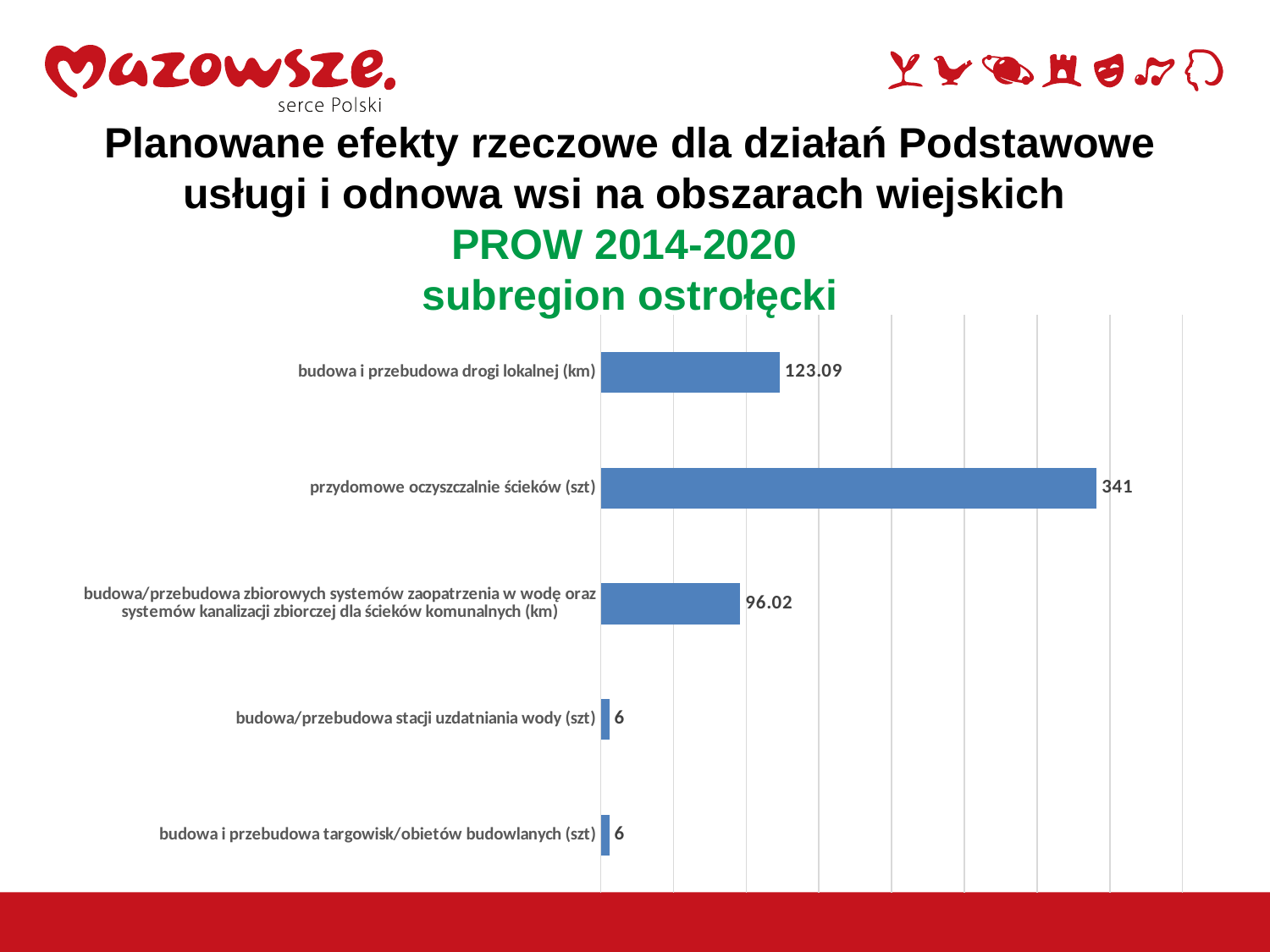
What is the value for 'budowa/przebudowa stacji uzdatniania wody (szt)'? 6 What colour are the bars in the chart? blue What is the difference between the value for 'budowa i przebudowa drogi lokalnej (km)' and the value for 'budowa/przebudowa zbiorowych systemów zaopatrzenia w wodę oraz systemów kanalizacji zbiorczej dla ścieków komunalnych (km)'? 27.07 What kind of chart is shown on the slide? bar chart What is the value for 'budowa/przebudowa zbiorowych systemów zaopatrzenia w wodę oraz systemów kanalizacji zbiorczej dla ścieków komunalnych (km)'? 96.02 What is the difference between the value for 'przydomowe oczyszczalnie ścieków (szt)' and the value for 'budowa i przebudowa drogi lokalnej (km)'? 217.91 What is the value for 'przydomowe oczyszczalnie ścieków (szt)'? 341 Which is larger: the value for 'budowa i przebudowa drogi lokalnej (km)' or the value for 'budowa/przebudowa zbiorowych systemów zaopatrzenia w wodę oraz systemów kanalizacji zbiorczej dla ścieków komunalnych (km)'? budowa i przebudowa drogi lokalnej (km) Which category has the highest value? przydomowe oczyszczalnie ścieków (szt) How many categories are shown in the chart? 5 What is the value for 'budowa i przebudowa targowisk/obietów budowlanych (szt)'? 6 What is the value for 'budowa i przebudowa drogi lokalnej (km)'? 123.09